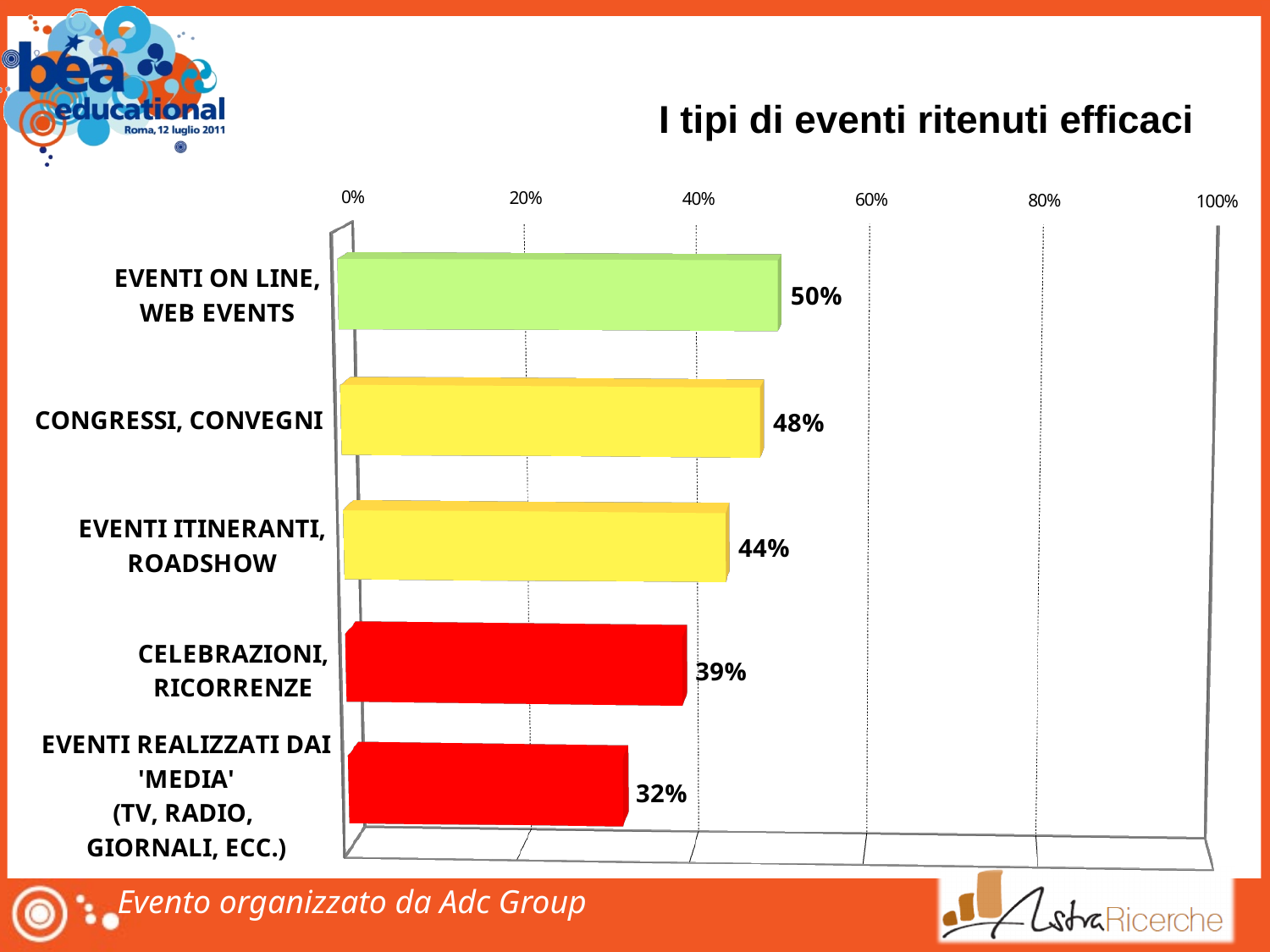
What is the difference between the values for EVENTI ON LINE, WEB EVENTS and EVENTI REALIZZATI DAI 'MEDIA'? 18% What is the title of the chart? I tipi di eventi ritenuti efficaci Which category has the highest value? EVENTI ON LINE, WEB EVENTS Which category has the lowest value? EVENTI REALIZZATI DAI 'MEDIA' (TV, RADIO, GIORNALI, ECC.) What is the value for CELEBRAZIONI, RICORRENZE? 39% What is the value for EVENTI REALIZZATI DAI 'MEDIA' (TV, RADIO, GIORNALI, ECC.)? 32% What kind of chart is shown on the slide? Bar chart What is the value for EVENTI ITINERANTI, ROADSHOW? 44% How many categories are shown in the chart? 5 Which is larger, the value for CONGRESSI, CONVEGNI or the value for CELEBRAZIONI, RICORRENZE? CONGRESSI, CONVEGNI What is the value for EVENTI ON LINE, WEB EVENTS? 50% What is the value for CONGRESSI, CONVEGNI? 48%